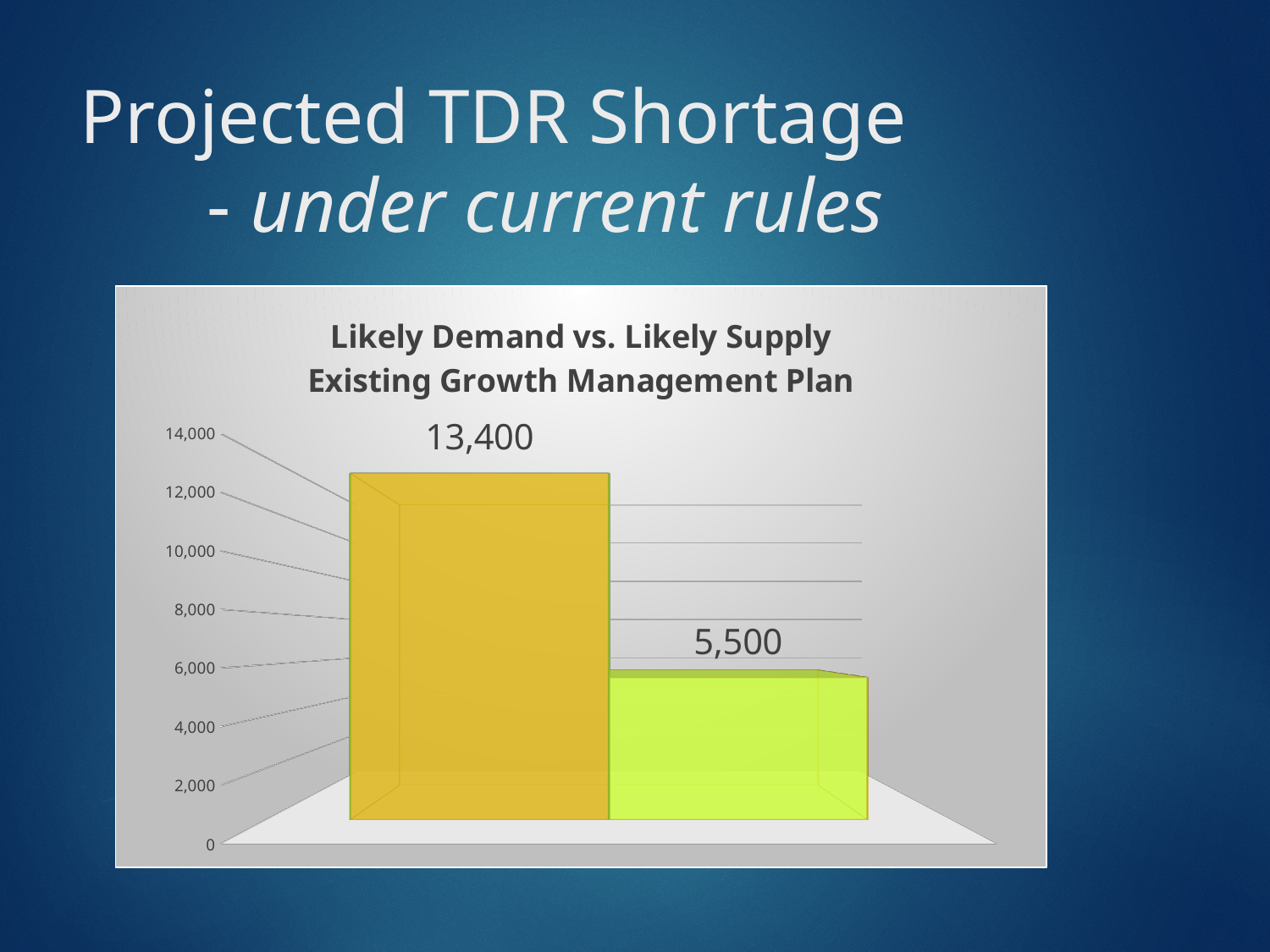
What is the highest value labelled on the chart's vertical axis? 14,000 Is the value of the left bar greater or less than 12,000? greater Is the value of the right bar greater or less than 6,000? less What value is shown on the right (yellow-green) bar of the chart? 5,500 What is the title of the chart? Likely Demand vs. Likely Supply Existing Growth Management Plan What kind of chart is shown on the slide? bar chart What is the highest value shown on the chart's bars? 13,400 What value is shown on the left (orange) bar of the chart? 13,400 How many bars are plotted on the chart? 2 What is the difference between the two bar values shown on the chart? 7,900 Which bar has the higher value, the left bar or the right bar? the left bar What is the lowest value shown on the chart's bars? 5,500